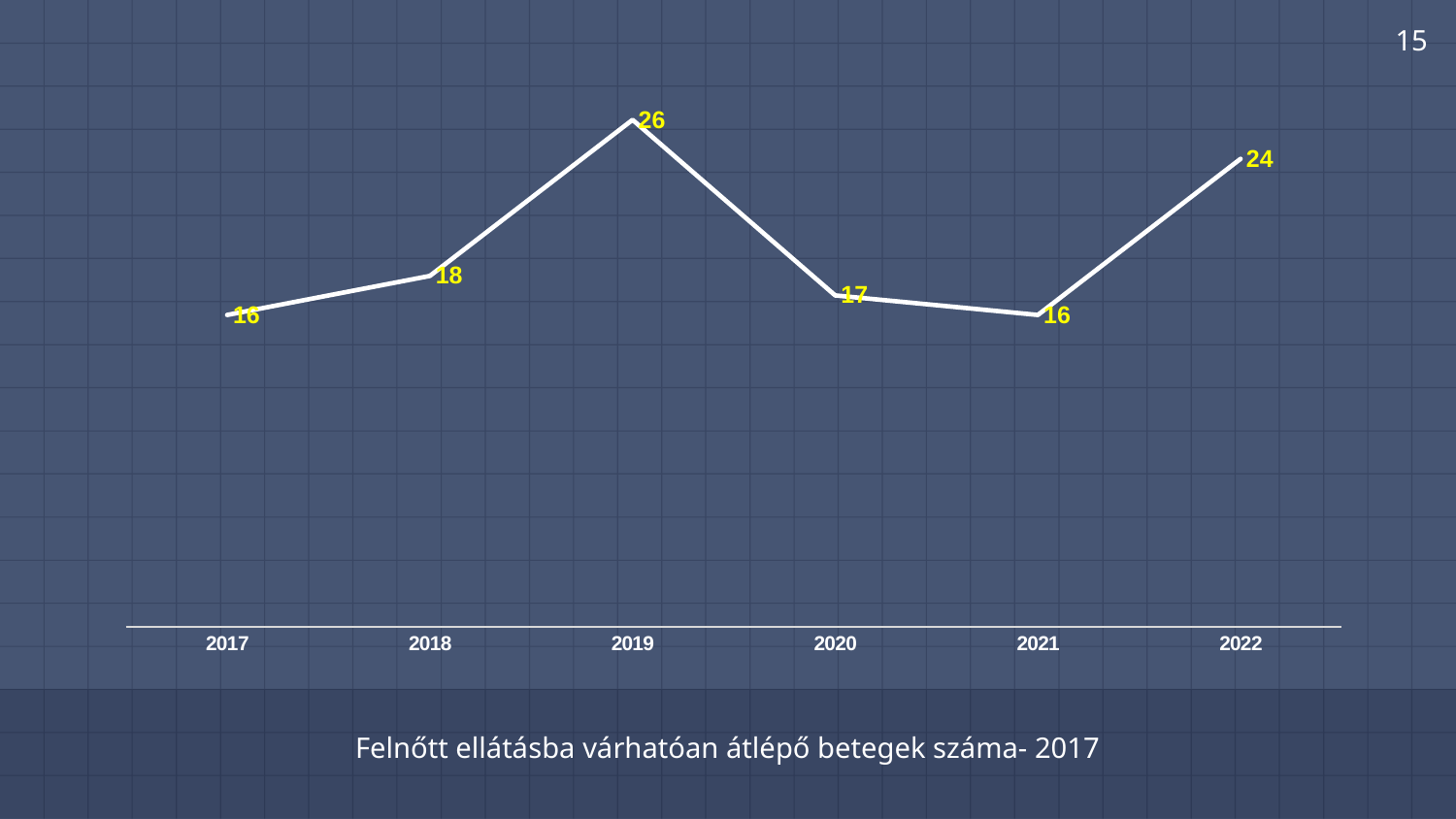
What is the difference between the values for 2019 and 2021? 10 Which year has the highest value? 2019 What is the value for 2019? 26 What is the value for 2022? 24 Which is larger, the value for 2018 or the value for 2020? 2018 How many years are plotted on the x axis? 6 Does the value rise or fall from 2021 to 2022? Rise What is the difference between the values for 2022 and 2020? 7 What kind of chart is shown on the slide? Line chart What is the value for 2018? 18 What is the value for 2020? 17 What is the title text shown below the chart? Felnőtt ellátásba várhatóan átlépő betegek száma- 2017